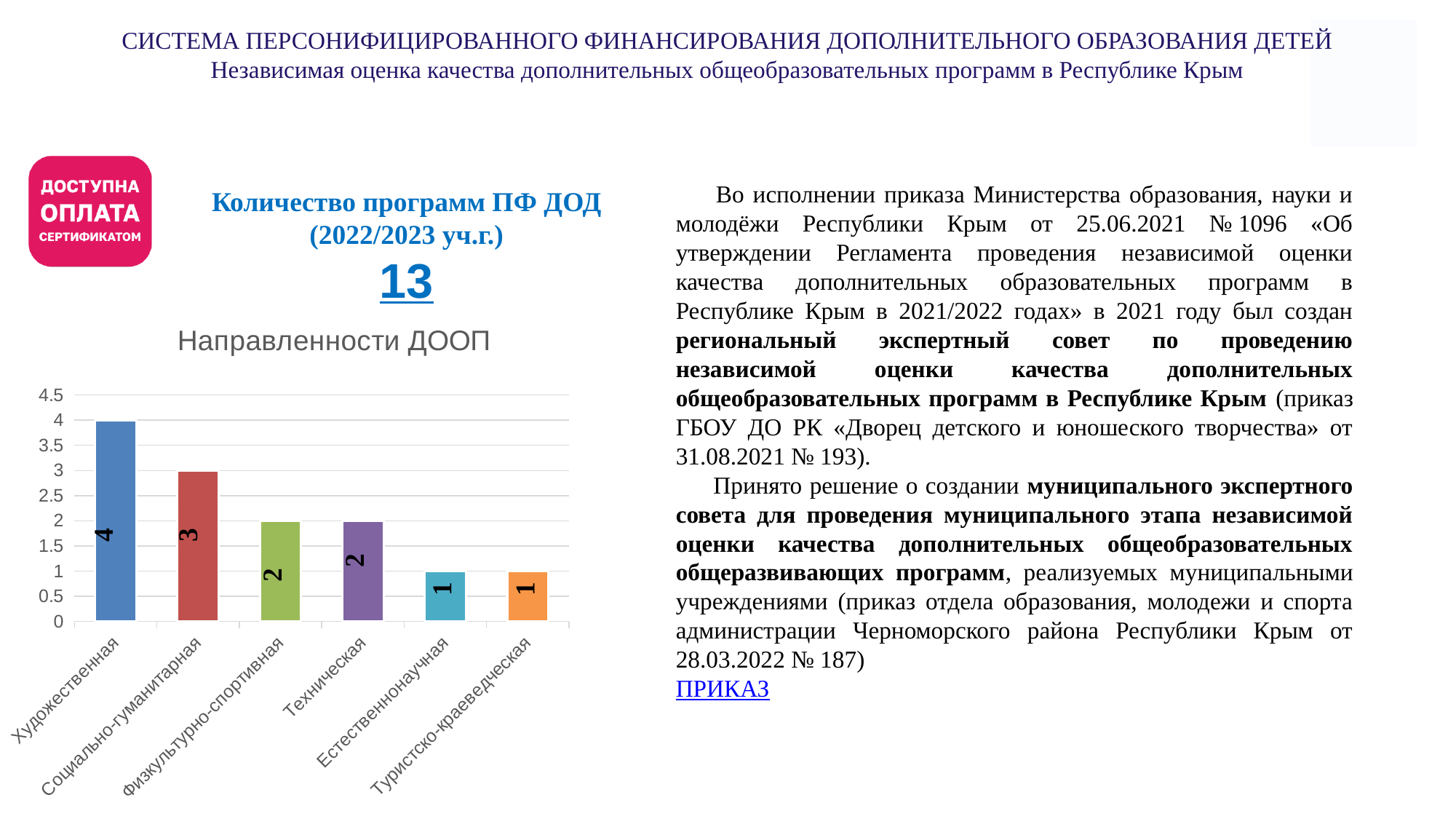
Which category has the highest value? Художественная Do the values rise or fall from left to right along the x axis? fall What is the value for Социально-гуманитарная? 3 How many categories are shown on the x axis of the chart? 6 Is the value for Художественная greater or less than 3.5? greater Which is larger, the value for Физкультурно-спортивная or the value for Туристско-краеведческая? Физкультурно-спортивная What type of chart is shown under the title "Направленности ДООП"? bar chart What is the title of the chart? Направленности ДООП What is the value for Художественная? 4 What is the difference between the values for Техническая and Естественнонаучная? 1 What is the difference between the values for Художественная and Социально-гуманитарная? 1 What is the value for Естественнонаучная? 1